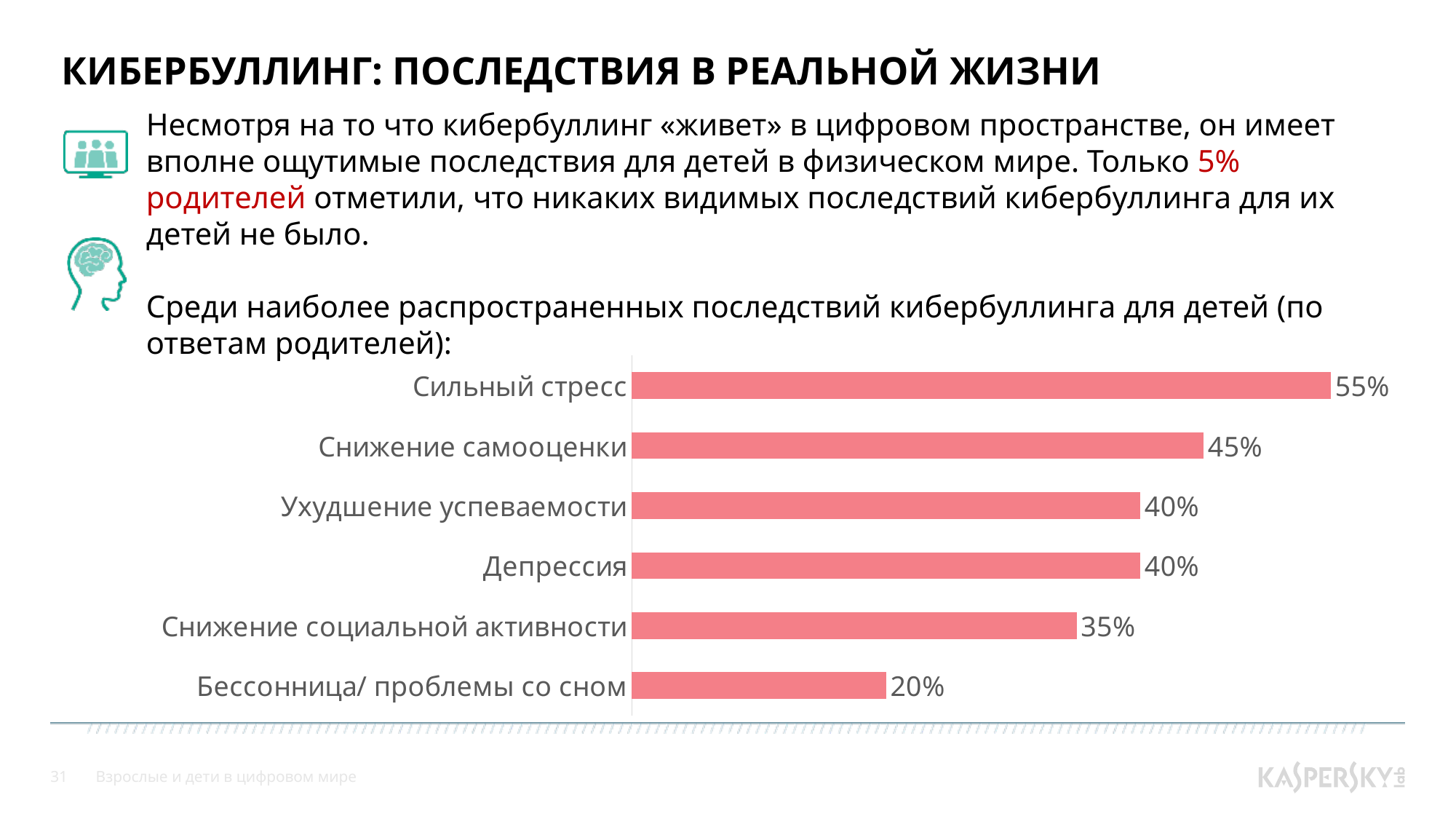
What is the value for Сильный стресс? 55% What is the value for Снижение социальной активности? 35% What is the difference between the values for Депрессия and Бессонница/ проблемы со сном? 20% How many categories are shown in the chart? 6 What is the value for Бессонница/ проблемы со сном? 20% What colour are the bars in the chart? Pink/red What is the difference between the values for Сильный стресс and Снижение самооценки? 10% What is the value for Снижение самооценки? 45% Which category has the highest value? Сильный стресс What kind of chart is shown on the slide? Bar chart Which category has the lowest value? Бессонница/ проблемы со сном Which is larger, the value for Ухудшение успеваемости or the value for Снижение социальной активности? Ухудшение успеваемости